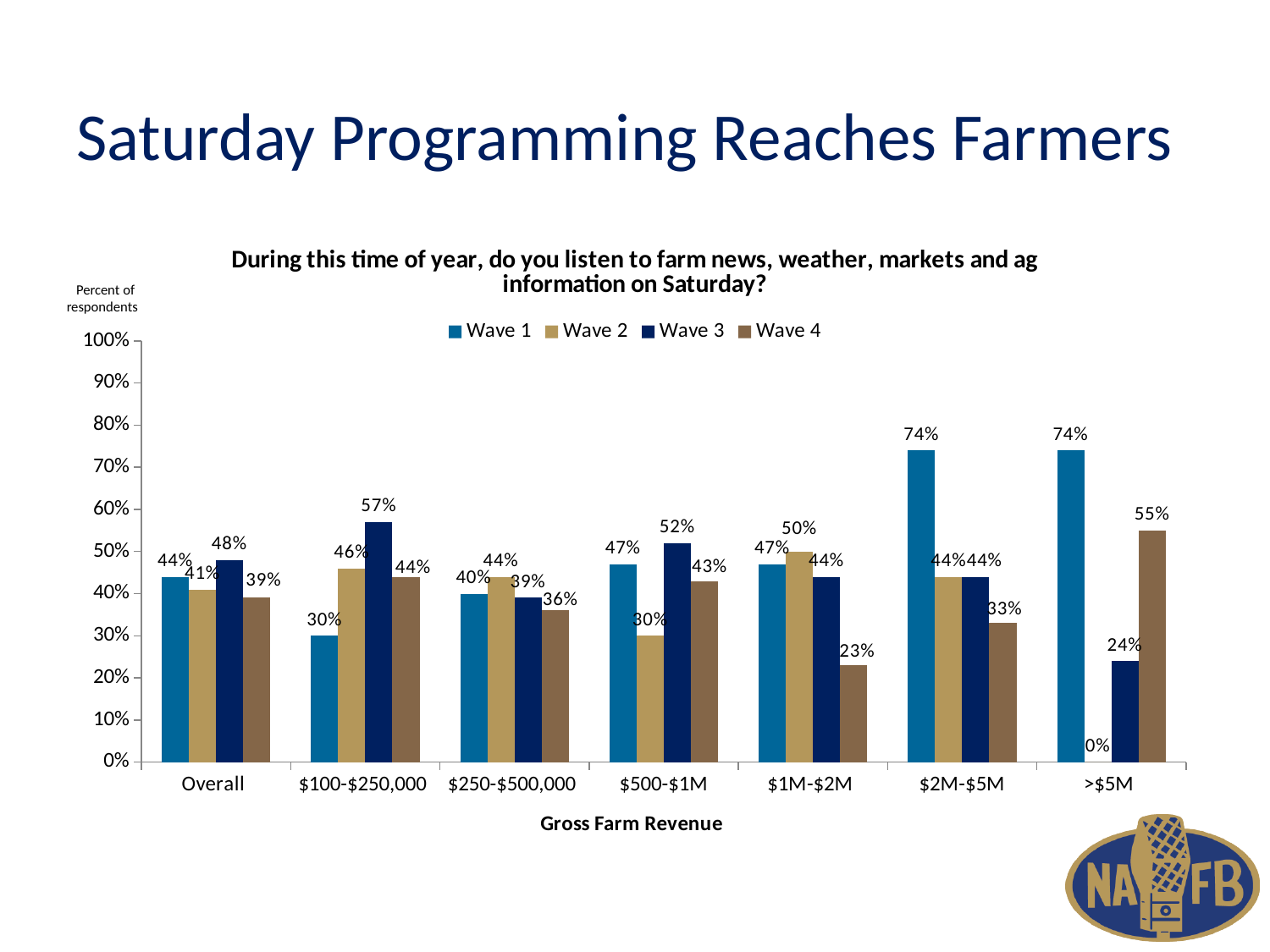
Which category has the lowest Wave 4 value? $1M-$2M What is the Wave 4 value for the $1M-$2M category? 23% For the $100-$250,000 category, which is larger: the Wave 1 value or the Wave 3 value? Wave 3 How many gross farm revenue categories are shown on the x axis? 7 What is the Wave 2 value for the >$5M category? 0% How many series does the legend list? 4 What is the Wave 3 value for the Overall category? 48% What is the difference between the Wave 1 and Wave 2 values for the $500-$1M category? 17% Which category has the highest Wave 3 value? $100-$250,000 What kind of chart is shown on the slide? Bar chart What is the Wave 1 value for the $2M-$5M category? 74% What is the x-axis title of the chart? Gross Farm Revenue